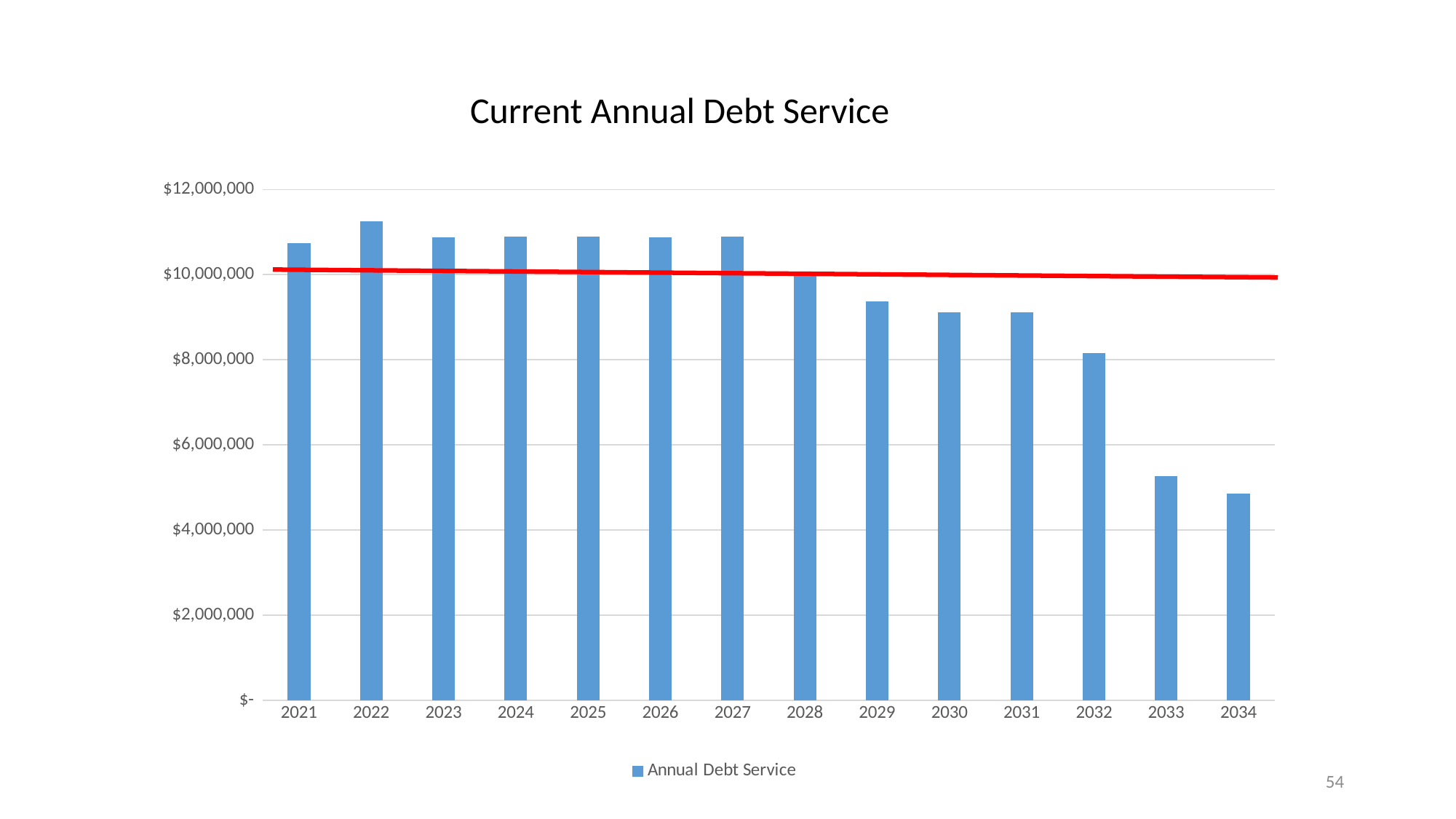
Is the value for 2029 greater or less than $10,000,000? less Do the annual debt service values generally rise or fall from 2021 to 2034? Fall Which is larger, the value for 2032 or the value for 2033? 2032 Is the value for 2034 greater or less than $4,000,000? greater Is the value for 2033 greater or less than $6,000,000? less How many series does the legend list? 1 Which year has the lowest annual debt service? 2034 How many years are shown on the x axis of the chart? 14 Which year has the highest annual debt service? 2022 What is the title of the chart? Current Annual Debt Service What kind of chart is shown on the slide? Bar chart